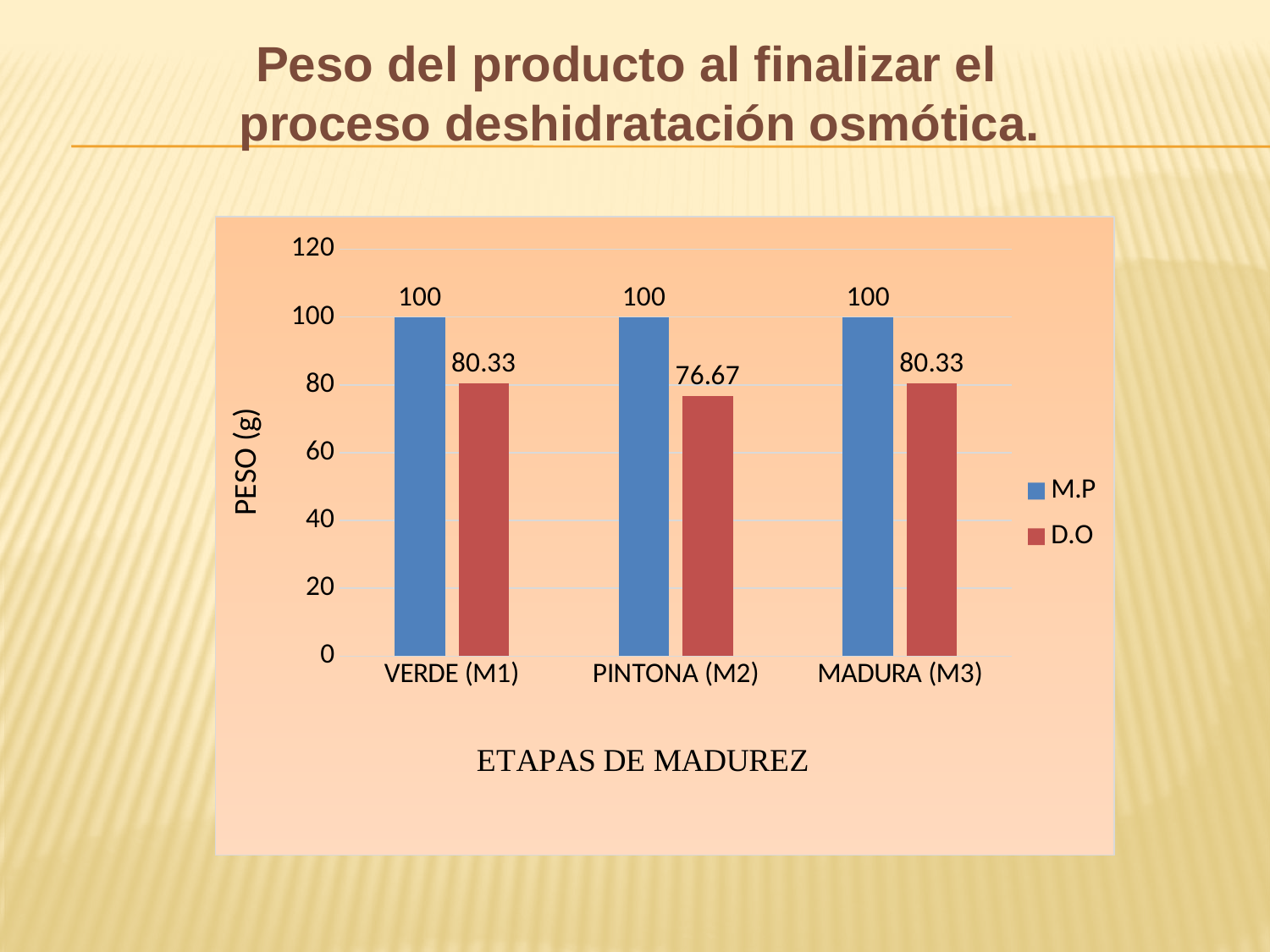
What is the D.O value for VERDE (M1)? 80.33 How many maturity stages are shown on the x axis? 3 Which is larger, the D.O value for VERDE (M1) or the D.O value for PINTONA (M2)? VERDE (M1) What is the difference between the D.O values for VERDE (M1) and PINTONA (M2)? 3.66 Which series is shown in red? D.O What kind of chart is shown on the slide? Bar chart What is the M.P value for MADURA (M3)? 100 How many series does the legend list? 2 What is the D.O value for PINTONA (M2)? 76.67 What is the difference between the M.P and D.O values for PINTONA (M2)? 23.33 What is the label of the y axis? PESO (g) Which maturity stage has the lowest D.O value? PINTONA (M2)